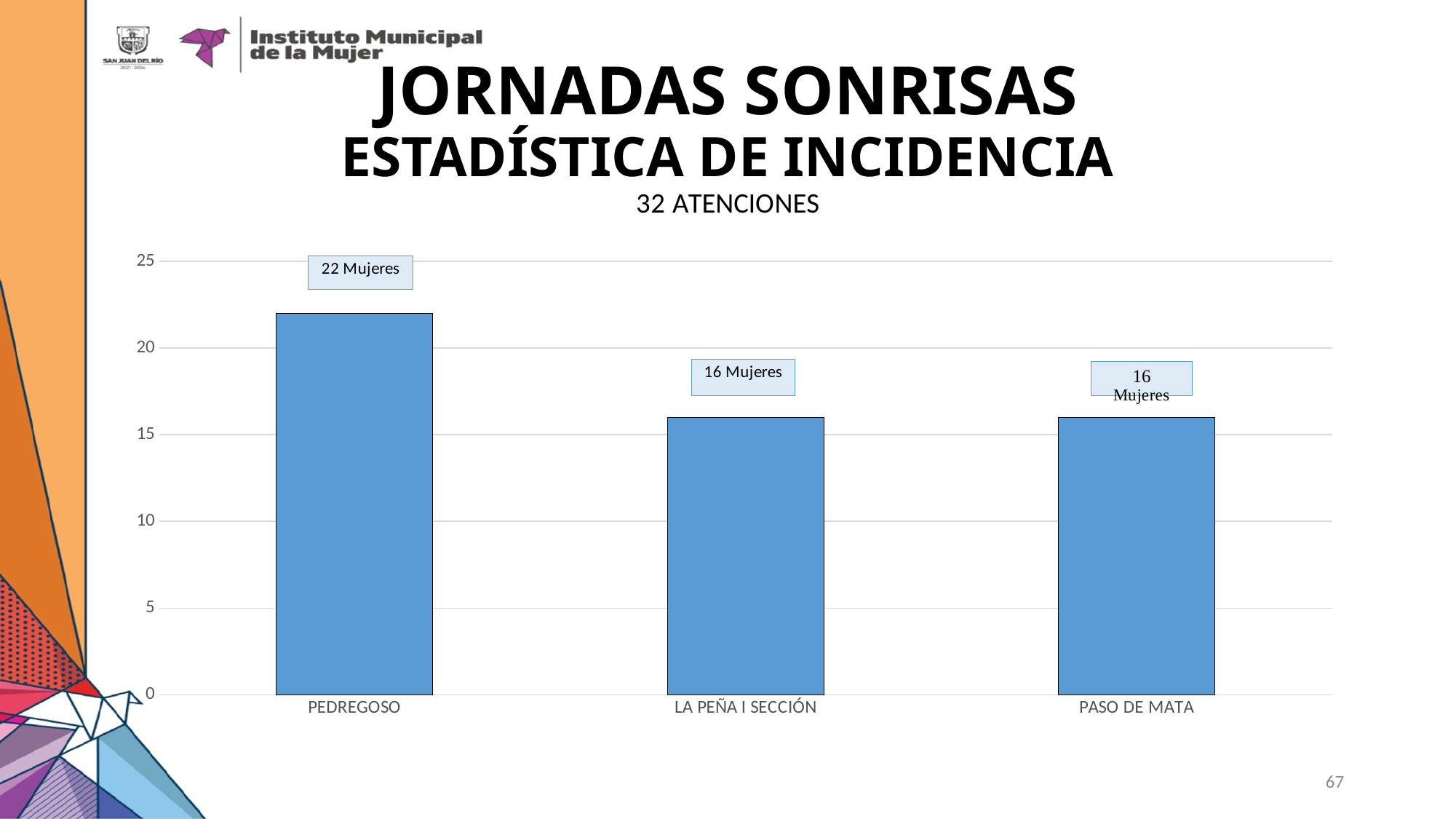
Is the value for LA PEÑA I SECCIÓN greater or less than 10? greater What is the value for PASO DE MATA? 16 Mujeres What is the title shown directly above the chart? 32 ATENCIONES What is the value for PEDREGOSO? 22 Mujeres What kind of chart is shown on the slide? bar chart How many categories are shown on the x axis? 3 Which is larger, the value for PEDREGOSO or the value for PASO DE MATA? PEDREGOSO Which category has the highest value? PEDREGOSO Is the value for PEDREGOSO greater or less than 20? greater What is the value for LA PEÑA I SECCIÓN? 16 Mujeres What is the difference between the values for PEDREGOSO and LA PEÑA I SECCIÓN? 6 What colour are the bars in the chart? blue